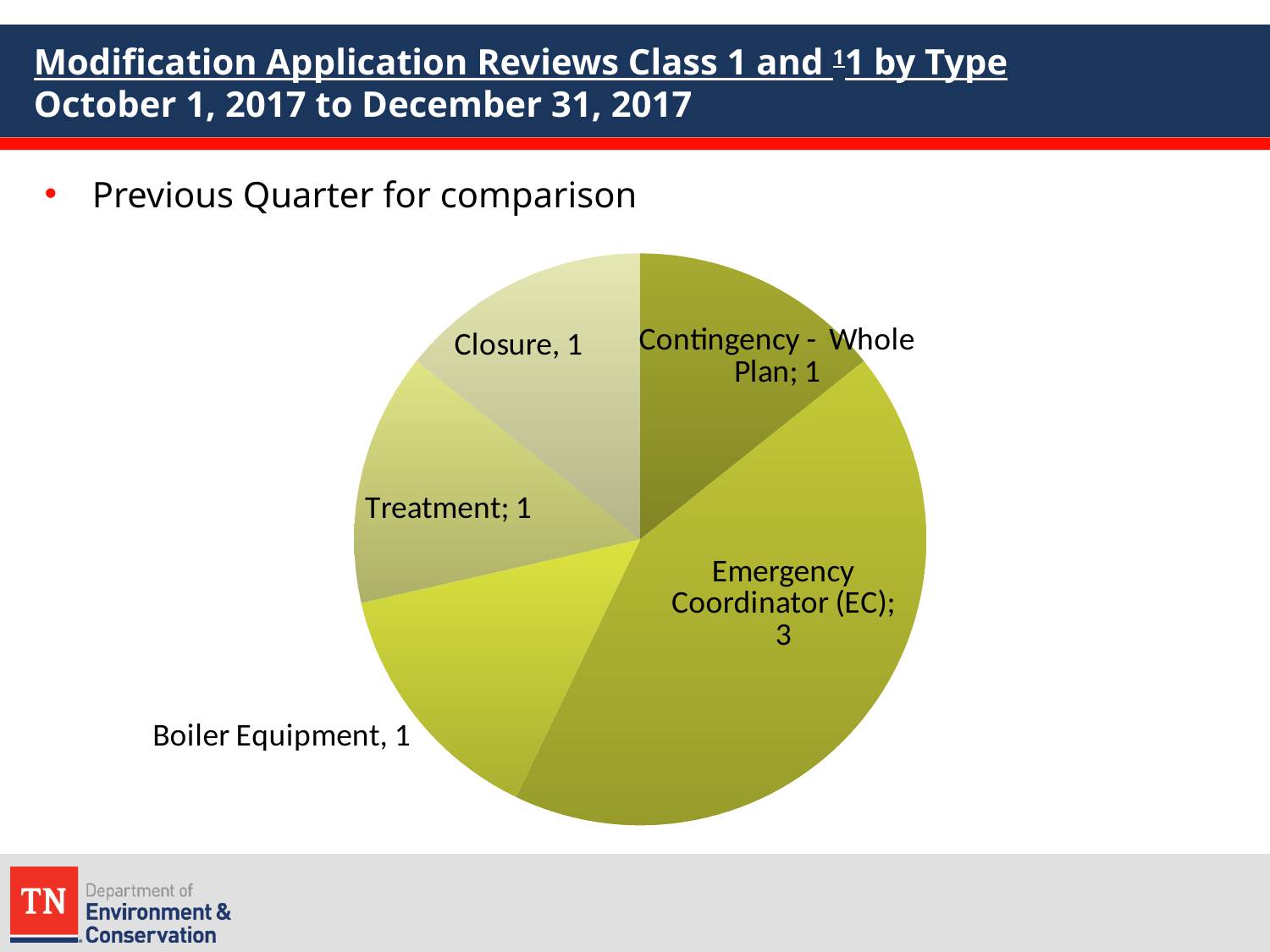
What is the value for Closure? 1 What is the value for Boiler Equipment? 1 What is the total of all the values shown in the pie chart? 7 What is the value for Emergency Coordinator (EC)? 3 Which is larger, the value for Emergency Coordinator (EC) or the value for Boiler Equipment? Emergency Coordinator (EC) How many slices does the pie chart have? 5 What date range does the slide title give for the modification application reviews? October 1, 2017 to December 31, 2017 What is the value for Contingency - Whole Plan? 1 Which category has the largest slice of the pie? Emergency Coordinator (EC) What is the value for Treatment? 1 What is the difference between the value for Emergency Coordinator (EC) and the value for Treatment? 2 What kind of chart is shown on the slide? pie chart